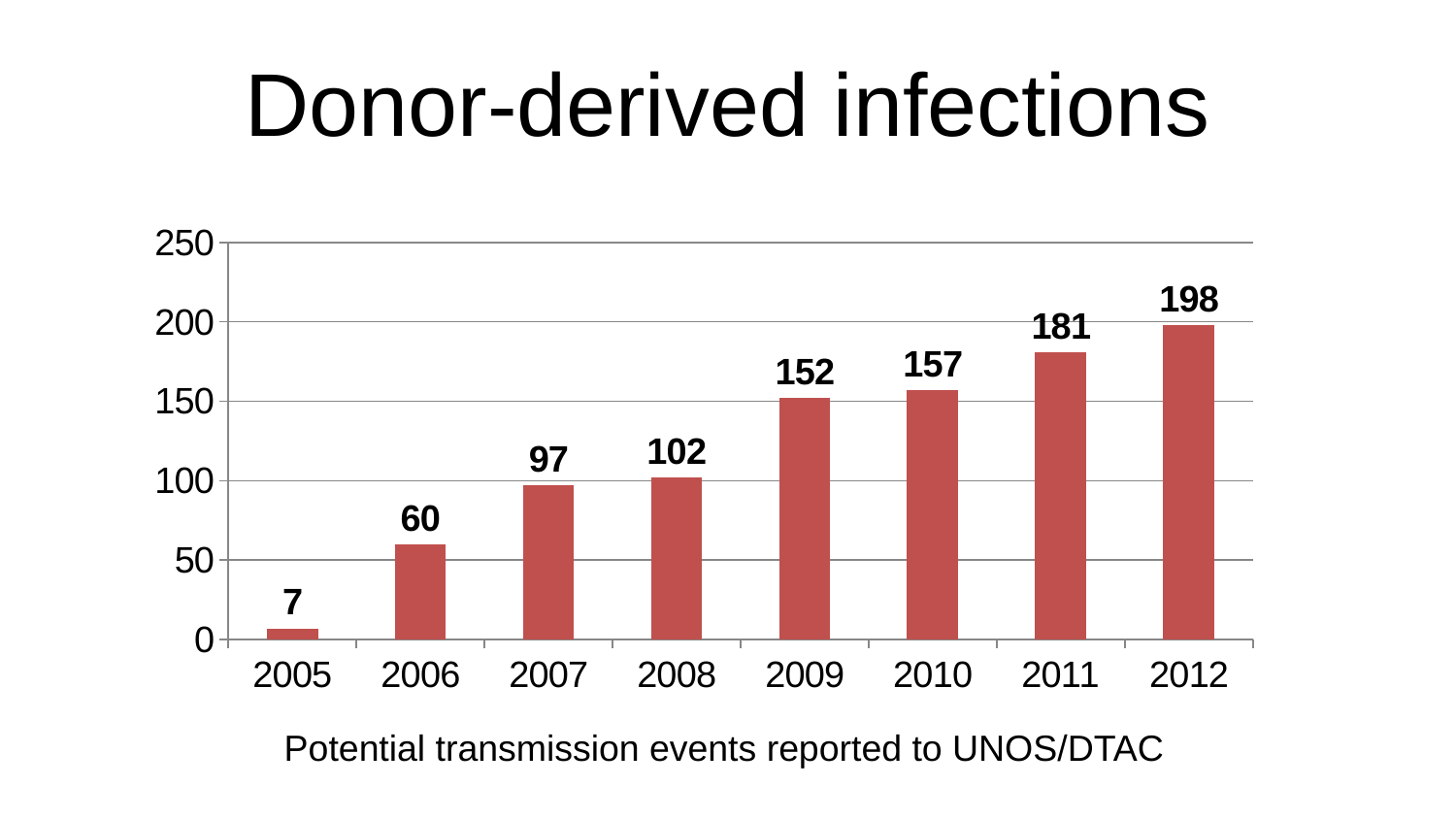
What is the difference between the values for 2012 and 2011? 17 What is the difference between the values for 2008 and 2007? 5 Which year has the lowest value? 2005 How many years are shown on the x axis? 8 What kind of chart is shown on the slide? bar chart What is the value for 2005? 7 Is the value for 2011 greater or less than 150? greater Which is larger, the value for 2006 or the value for 2010? 2010 What is the value for 2009? 152 Do the values rise or fall from 2005 to 2012? rise What is the value for 2012? 198 Which year has the highest value? 2012